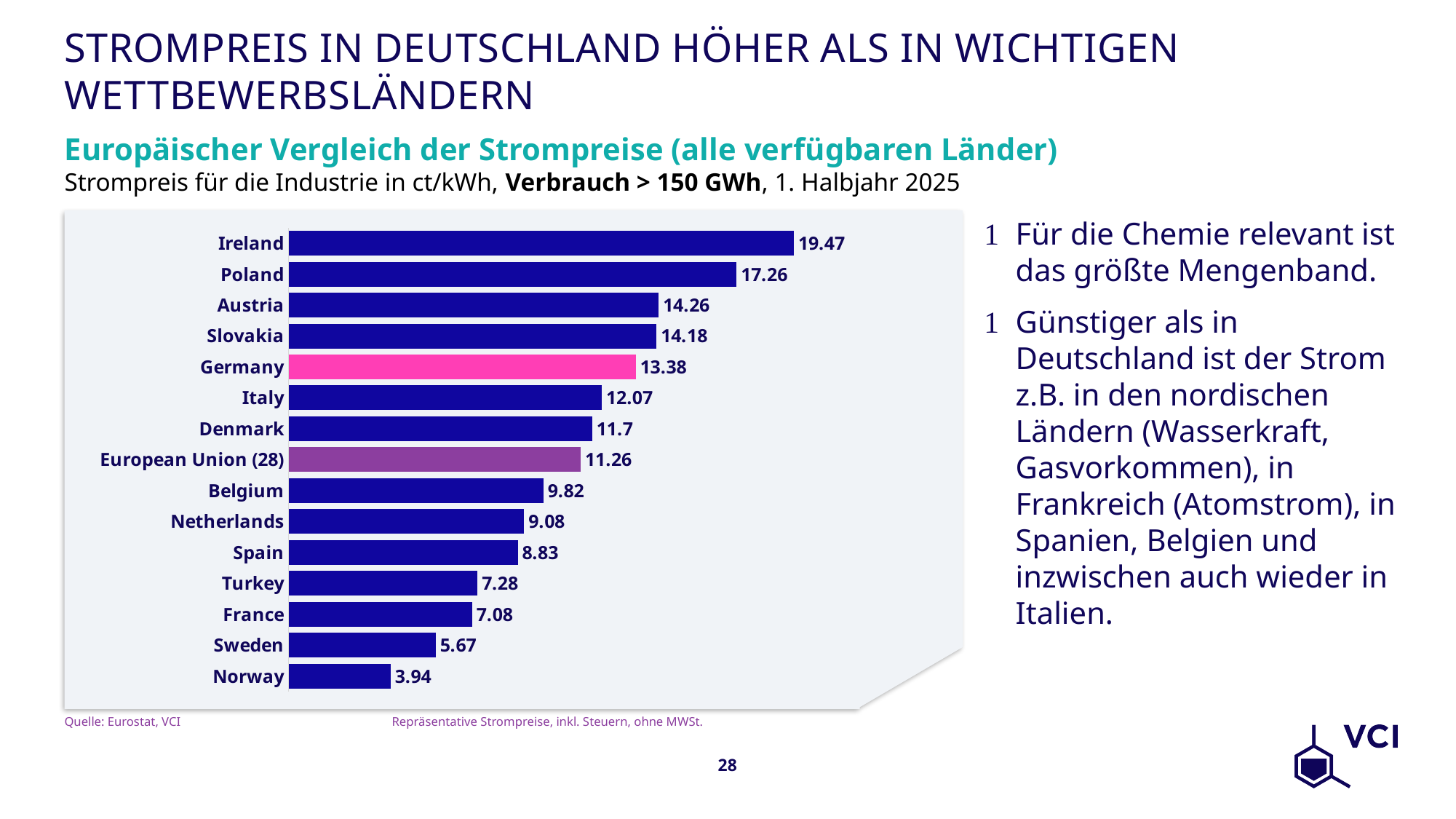
What kind of chart is shown on the slide? Bar chart What is the difference between the electricity price for Ireland and for Poland? 2.21 Which has a higher electricity price, Sweden or Norway? Sweden Which country has the highest electricity price? Ireland Which bar is highlighted in pink? Germany How many countries or regions are shown in the chart? 15 What is the electricity price for France? 7.08 What is the electricity price for European Union (28)? 11.26 What is the difference between the electricity price for Germany and for European Union (28)? 2.12 Which has a higher electricity price, Austria or Slovakia? Austria Which country has the lowest electricity price? Norway What is the electricity price for Germany? 13.38